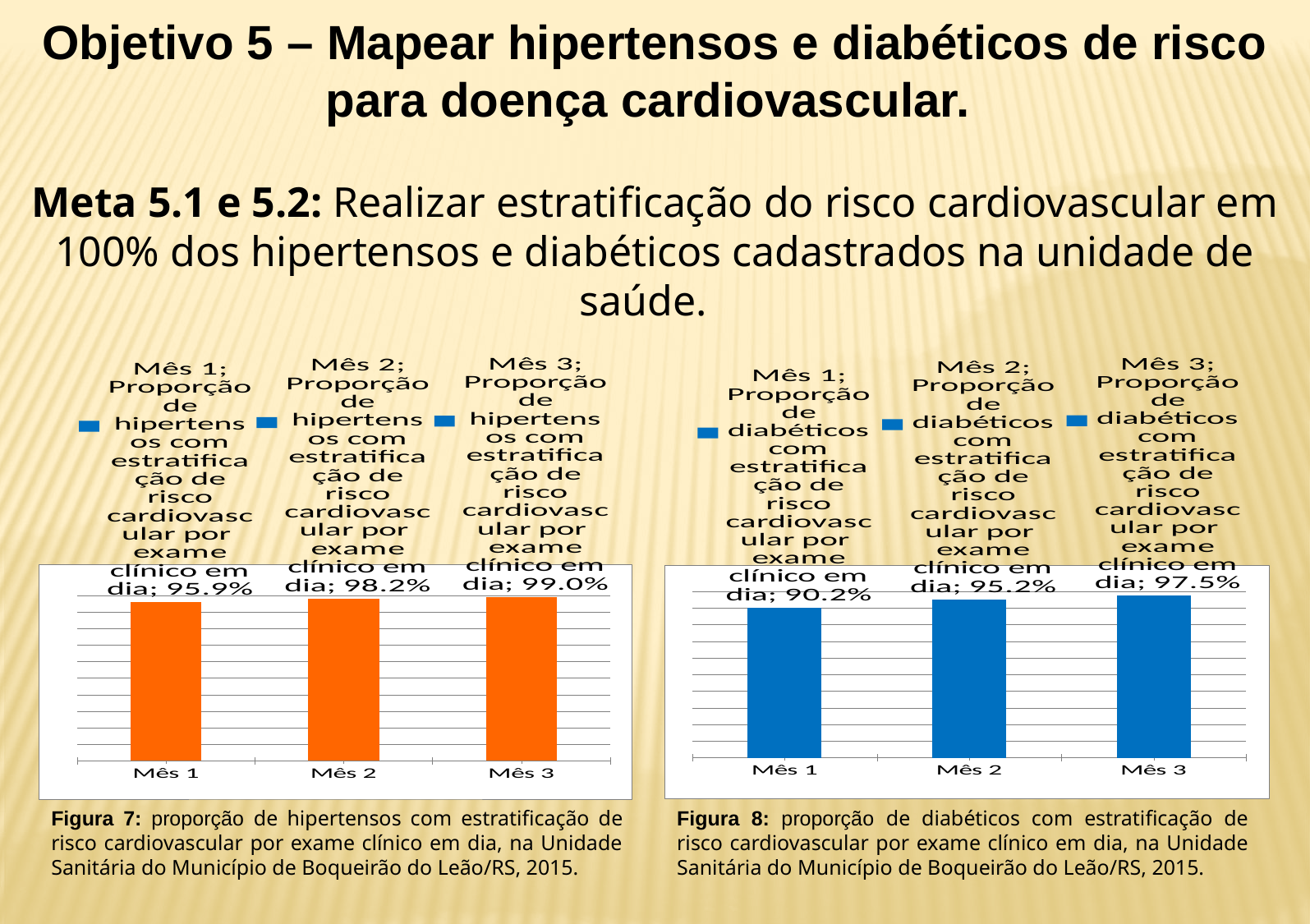
In the left chart (Figura 7), what is the difference between the values for Mês 2 and Mês 1? 2.3% In the right chart (Figura 8), which month has the highest value? Mês 3 In the right chart (Figura 8), what is the difference between the values for Mês 3 and Mês 1? 7.3% Which is larger: the Mês 1 value in the left chart (Figura 7) or the Mês 1 value in the right chart (Figura 8)? Left chart (Figura 7), 95.9% In the left chart (Figura 7), which month has the lowest value? Mês 1 In the right chart (Figura 8), what is the proportion of diabetic patients with cardiovascular risk stratification up to date in Mês 1? 90.2% In the left chart (Figura 7), what is the value for Mês 3? 99.0% In the right chart (Figura 8), what is the value for Mês 2? 95.2% What type of chart is used in Figura 7? Bar chart In the right chart (Figura 8), do the values rise or fall from Mês 1 to Mês 3? Rise In the left chart (Figura 7), what is the proportion of hypertensive patients with cardiovascular risk stratification up to date in Mês 1? 95.9% How many months (categories) are shown in the right chart (Figura 8)? 3